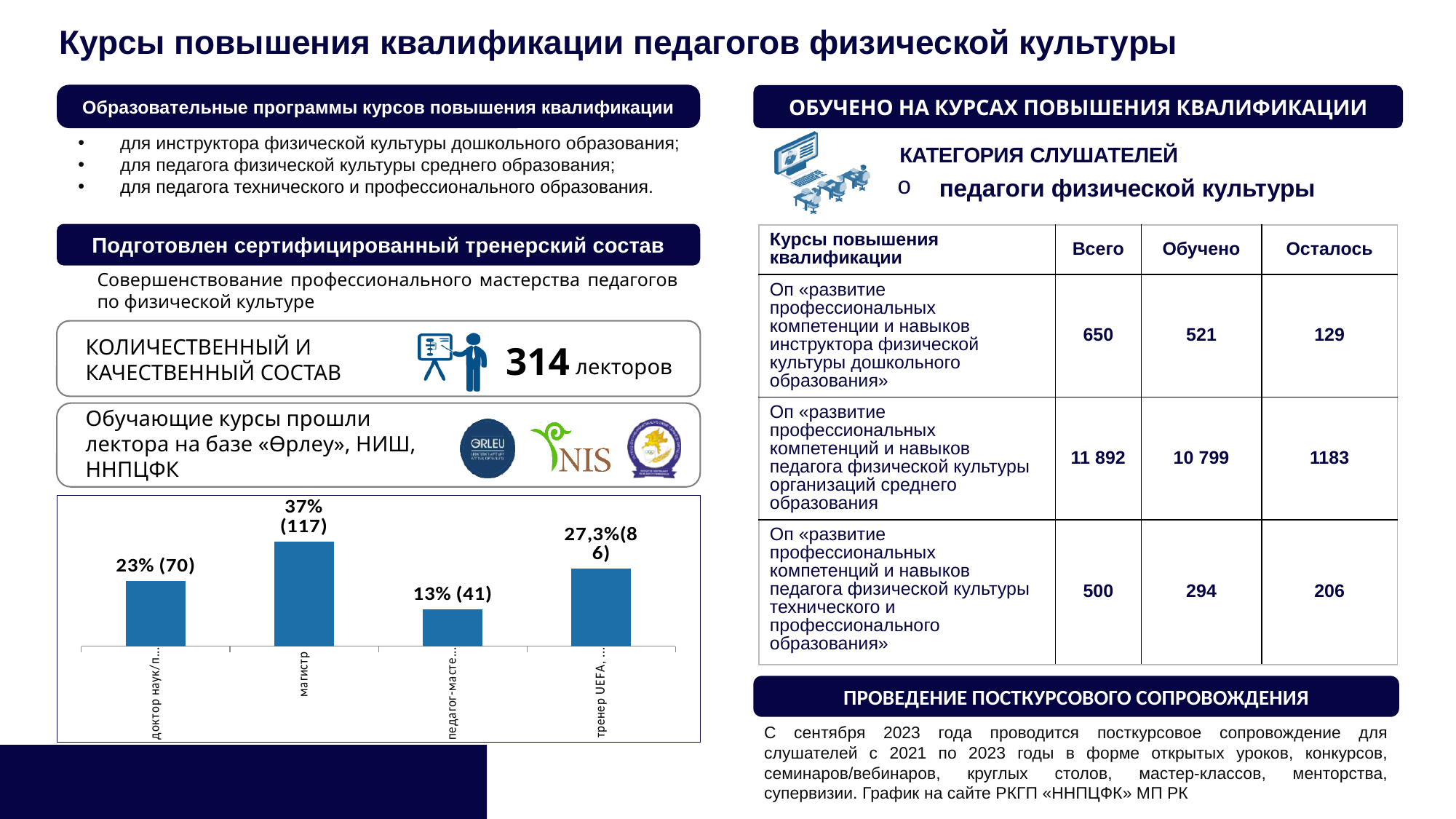
In the bar chart, which category has the highest value? магистр In the bar chart, what is the difference in lecturer count between магистр and the third bar? 76 How many bars does the bar chart at the bottom left of the slide have? 4 What colour are the bars in the bar chart? blue What kind of chart is shown at the bottom left of the slide? bar chart In the bar chart, what is the data label on the first (leftmost) bar, доктор наук? 23% (70) In the bar chart, what is the data label on the bar for магистр? 37% (117) In the bar chart, what is the data label on the third bar? 13% (41) In the bar chart, how many more lecturers are in the магистр category than in the first bar (доктор наук)? 47 In the bar chart, what is the data label on the fourth (rightmost) bar, тренер UEFA? 27,3%(86) In the bar chart, which bar has the lowest value? the third bar (13% (41)) In the bar chart, which is larger: the first bar (доктор наук) or the fourth bar (тренер UEFA)? the fourth bar (тренер UEFA)